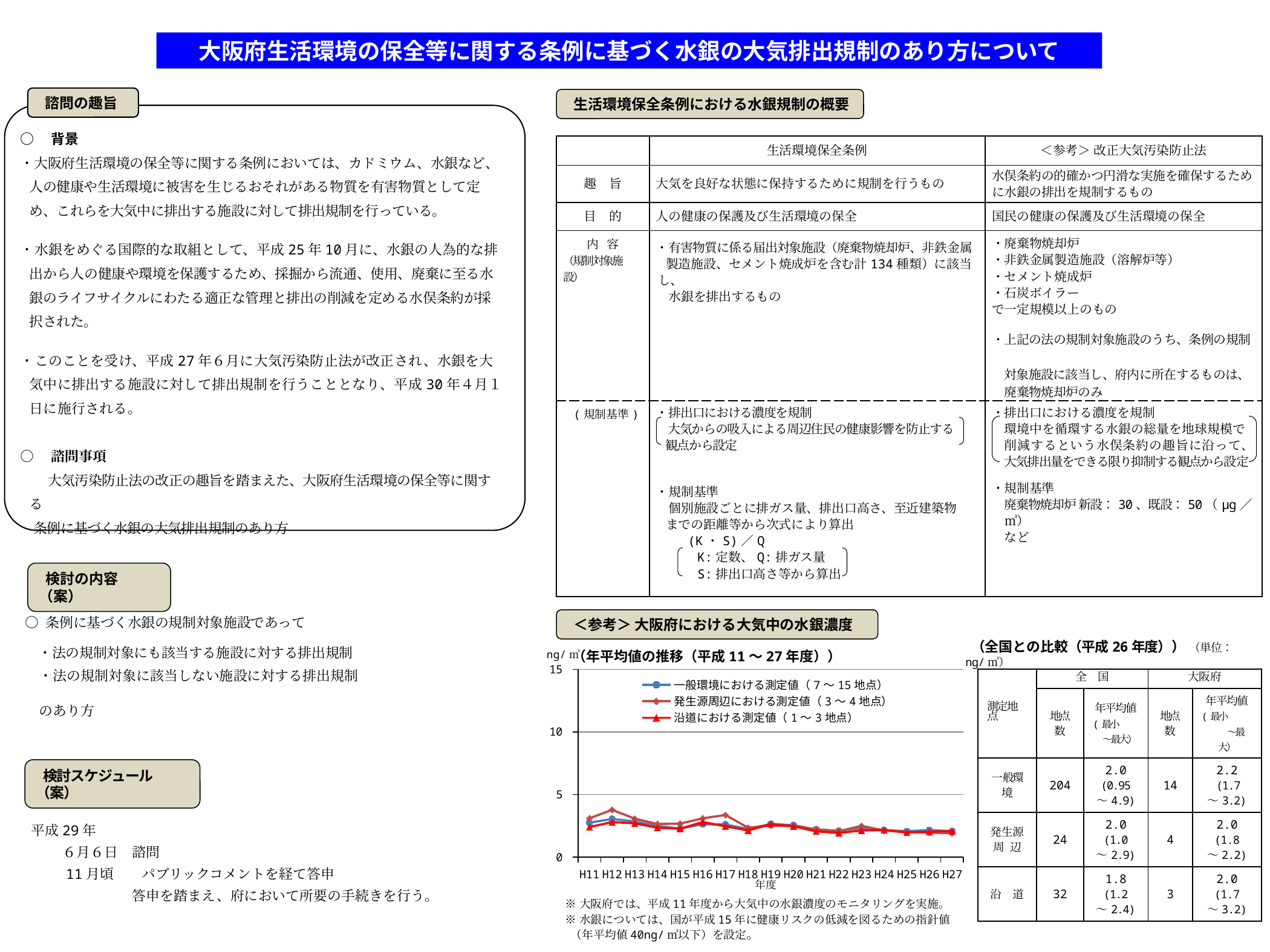
What unit is shown on the y axis of the line chart? ng/㎥ Is the value for 一般環境における測定値 at H27 greater or less than 5? less What is the first year label on the x axis of the line chart? H11 At H12, which is larger: 発生源周辺における測定値 or 沿道における測定値? 発生源周辺における測定値 Do the values for 一般環境における測定値 generally rise or fall from H11 to H27? fall How many fiscal years (points) are shown along the x axis of the line chart? 17 What is the last year label on the x axis of the line chart? H27 Is the value for 沿道における測定値 at H11 greater or less than 10? less How many series does the legend of the line chart list? 3 At H17, which series has the highest value in the line chart? 発生源周辺における測定値 Is the value for 発生源周辺における測定値 at H12 greater or less than 5? less What kind of chart is shown under ＜参考＞大阪府における大気中の水銀濃度? line chart